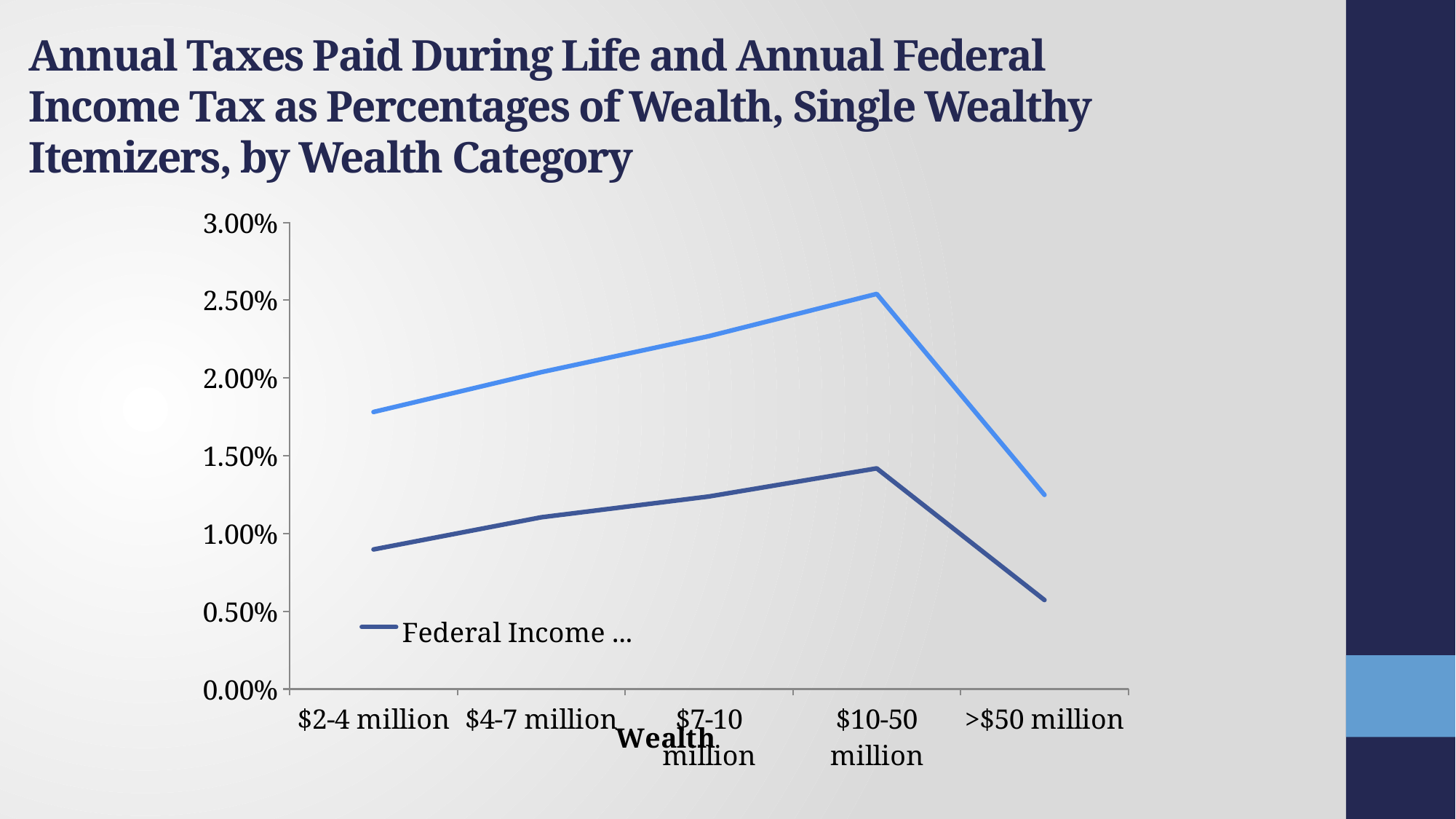
Which line is higher at the $4-7 million category, the light blue line or the dark blue Federal Income line? the light blue line What is the title of the x axis? Wealth Is the Federal Income series (dark blue line) value for $2-4 million greater or less than 1.00%? less How many wealth categories are shown on the x axis? 5 For which wealth category does the light blue line reach its highest value? $10-50 million How many lines are plotted on the chart? 2 Is the light blue line value for $7-10 million greater or less than 2.00%? greater For which wealth category does the Federal Income series (dark blue line) reach its highest value? $10-50 million For which wealth category is the light blue line lowest? >$50 million For which wealth category is the Federal Income series (dark blue line) lowest? >$50 million What kind of chart is shown on the slide? line chart Is the Federal Income series (dark blue line) value for $10-50 million greater or less than 1.50%? less